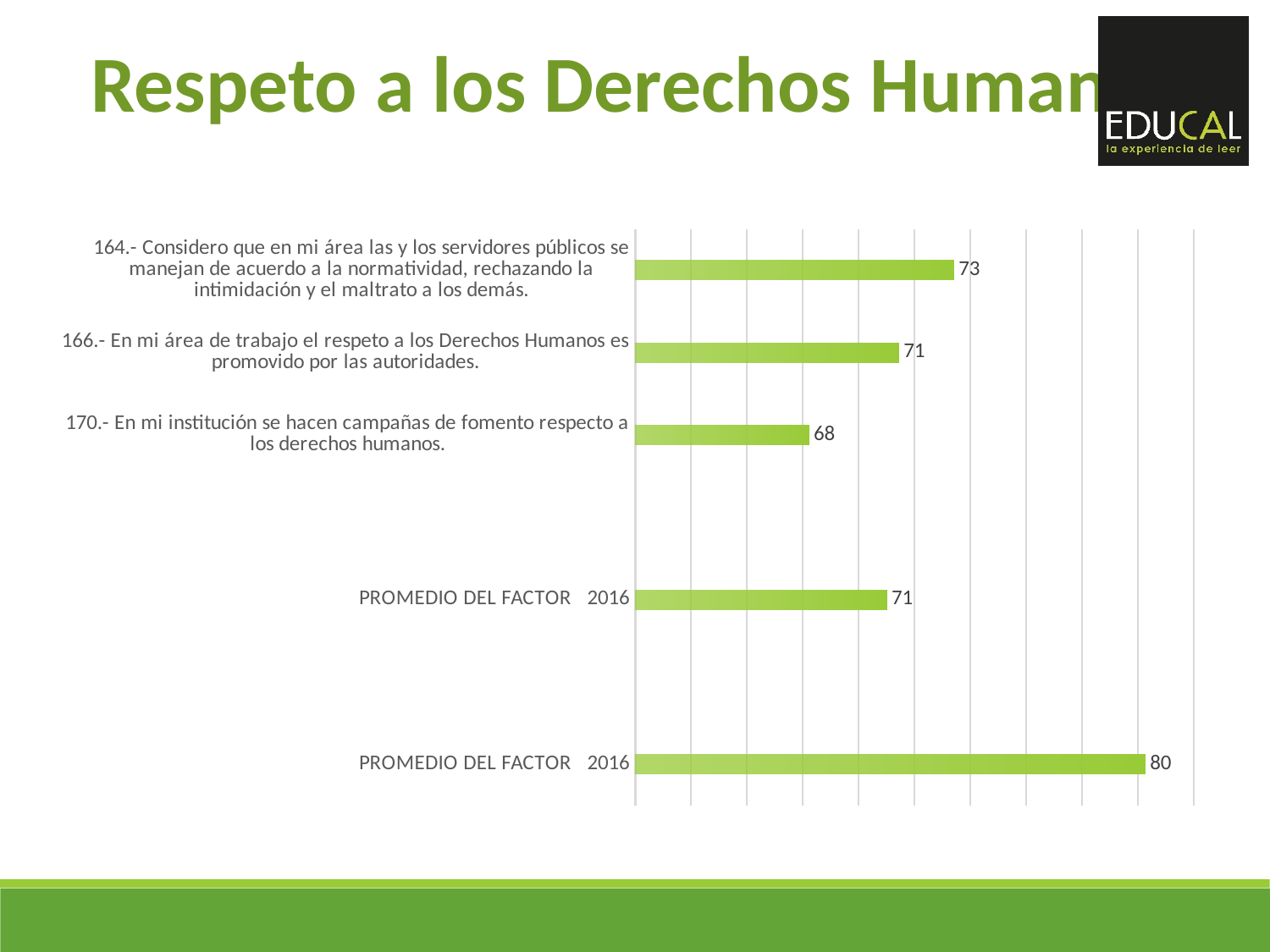
What is the difference between the value for item 164 and the value for item 170? 5 What is the value for item 166 ("En mi área de trabajo el respeto a los Derechos Humanos es promovido por las autoridades")? 71 What is the value of the bottom bar, labelled "PROMEDIO DEL FACTOR 2016"? 80 What kind of chart is shown on the slide? bar chart What is the value of the fourth bar from the top, the first one labelled "PROMEDIO DEL FACTOR 2016"? 71 Which is larger, the value for item 164 or the value for item 166? item 164 Which bar has the highest value in the chart? The bottom "PROMEDIO DEL FACTOR 2016" bar (80) What is the value for item 164 ("Considero que en mi área las y los servidores públicos se manejan de acuerdo a la normatividad...")? 73 What is the title of the slide containing the chart? Respeto a los Derechos Humanos Which of the three numbered items (164, 166, 170) has the lowest value? 170 How many bars are plotted in the chart? 5 What is the value for item 170 ("En mi institución se hacen campañas de fomento respecto a los derechos humanos")? 68